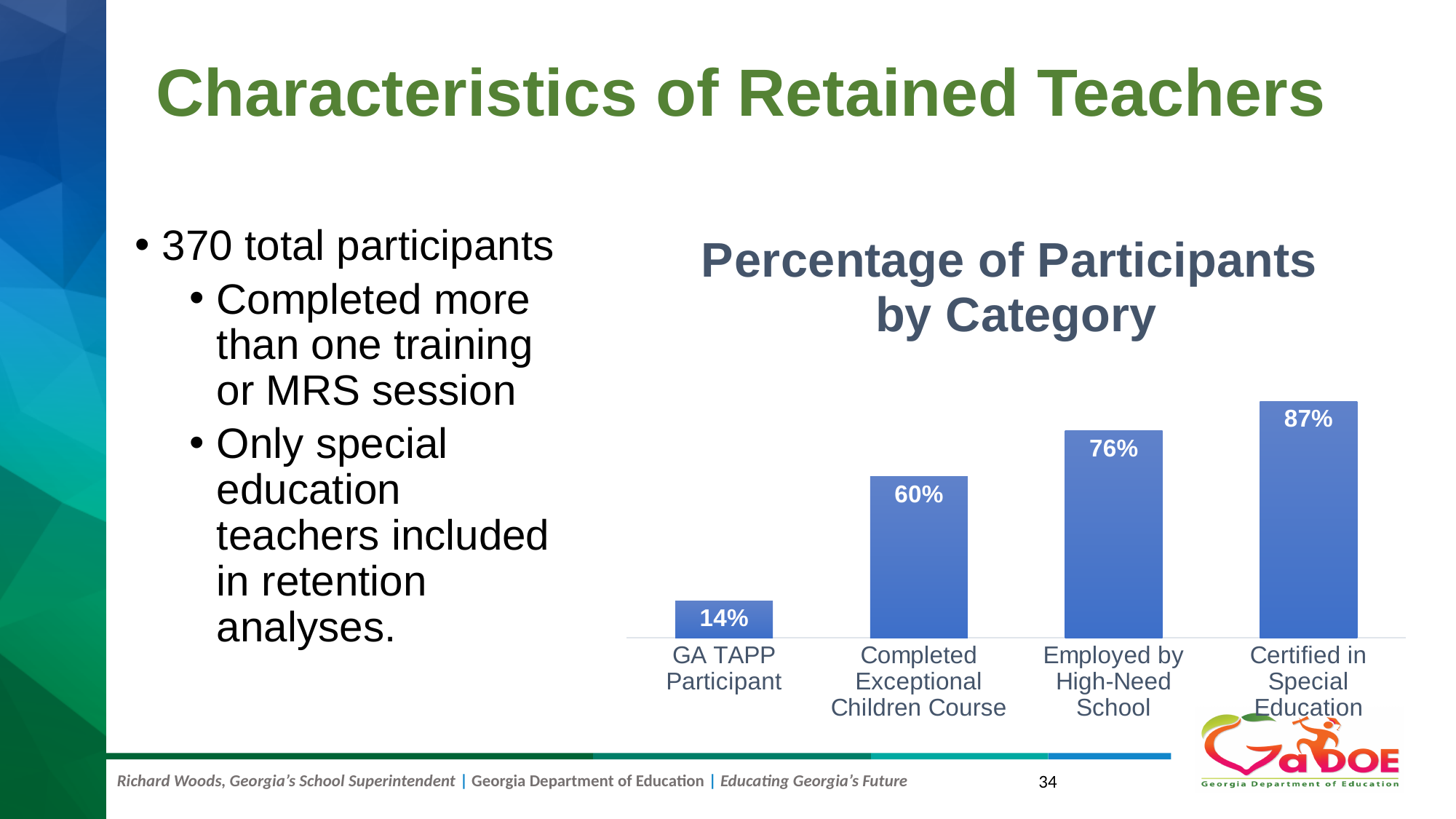
How many categories are shown in the chart? 4 Which category has the lowest percentage of participants? GA TAPP Participant Which category has the highest percentage of participants? Certified in Special Education What kind of chart is shown on the slide? Bar chart What percentage of participants Completed Exceptional Children Course? 60% What is the difference in percentage points between Certified in Special Education and GA TAPP Participant? 73 What is the title of the chart? Percentage of Participants by Category Which is larger: the percentage for Completed Exceptional Children Course or for Employed by High-Need School? Employed by High-Need School What percentage of participants were Employed by High-Need School? 76% What percentage of participants were GA TAPP Participants? 14% What percentage of participants were Certified in Special Education? 87% What is the difference in percentage points between Employed by High-Need School and Completed Exceptional Children Course? 16